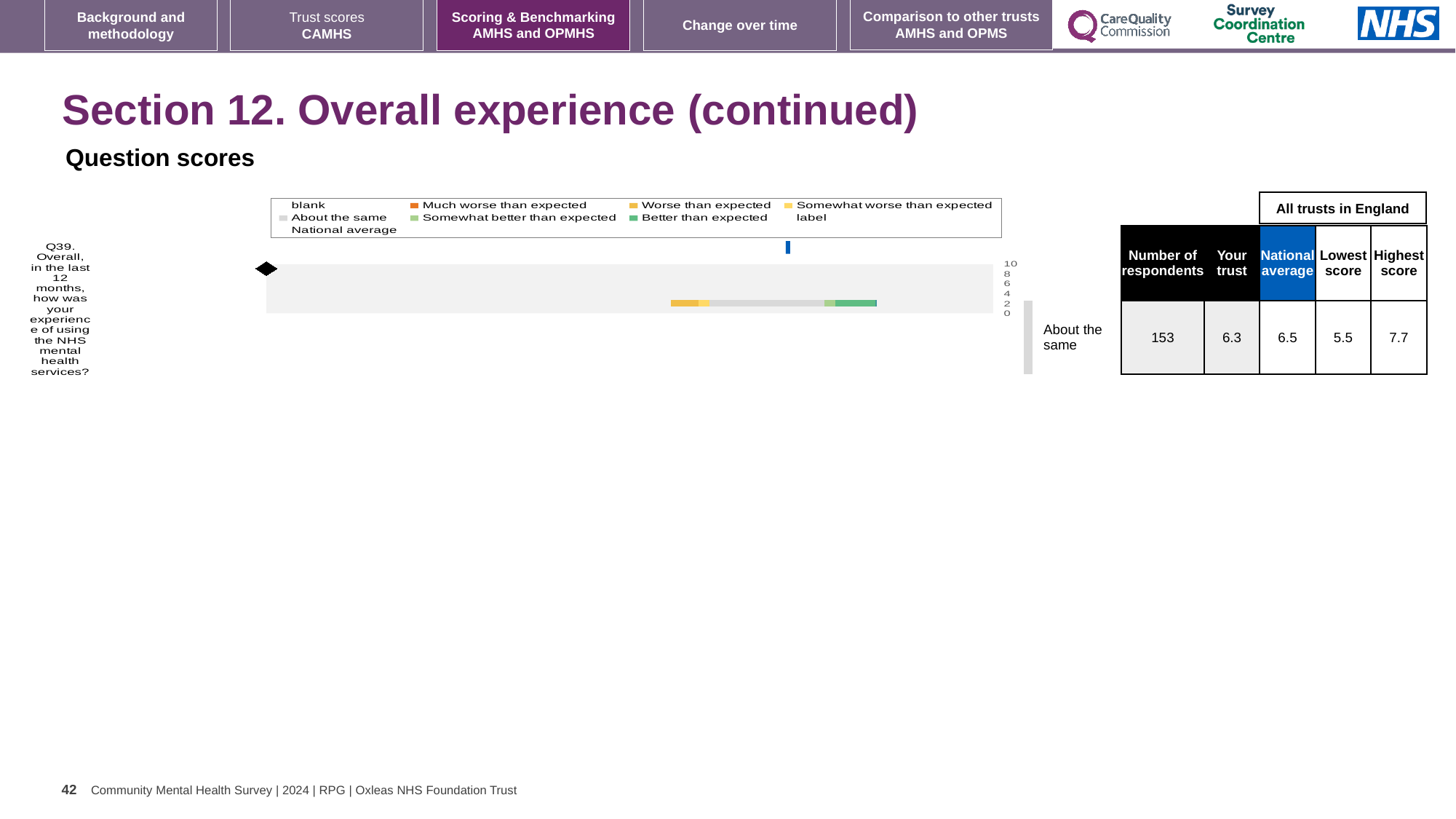
How many survey questions are plotted in the chart? 1 What is the difference between the highest score and the lowest score for Q39? 2.2 What is the national average score for Q39 shown in the table? 6.5 What type of chart is shown on the slide for Q39? bar chart How many respondents answered Q39? 153 What is the highest score across all trusts in England for Q39? 7.7 How many entries does the chart legend list? 9 What is the 'Your trust' score for Q39 shown in the table next to the chart? 6.3 What is the lowest score across all trusts in England for Q39? 5.5 By how much does the national average exceed the 'Your trust' score for Q39? 0.2 Which is larger for Q39: the 'Your trust' score or the national average? National average Which benchmark category is the trust's Q39 score placed in, according to the label beside the chart? About the same